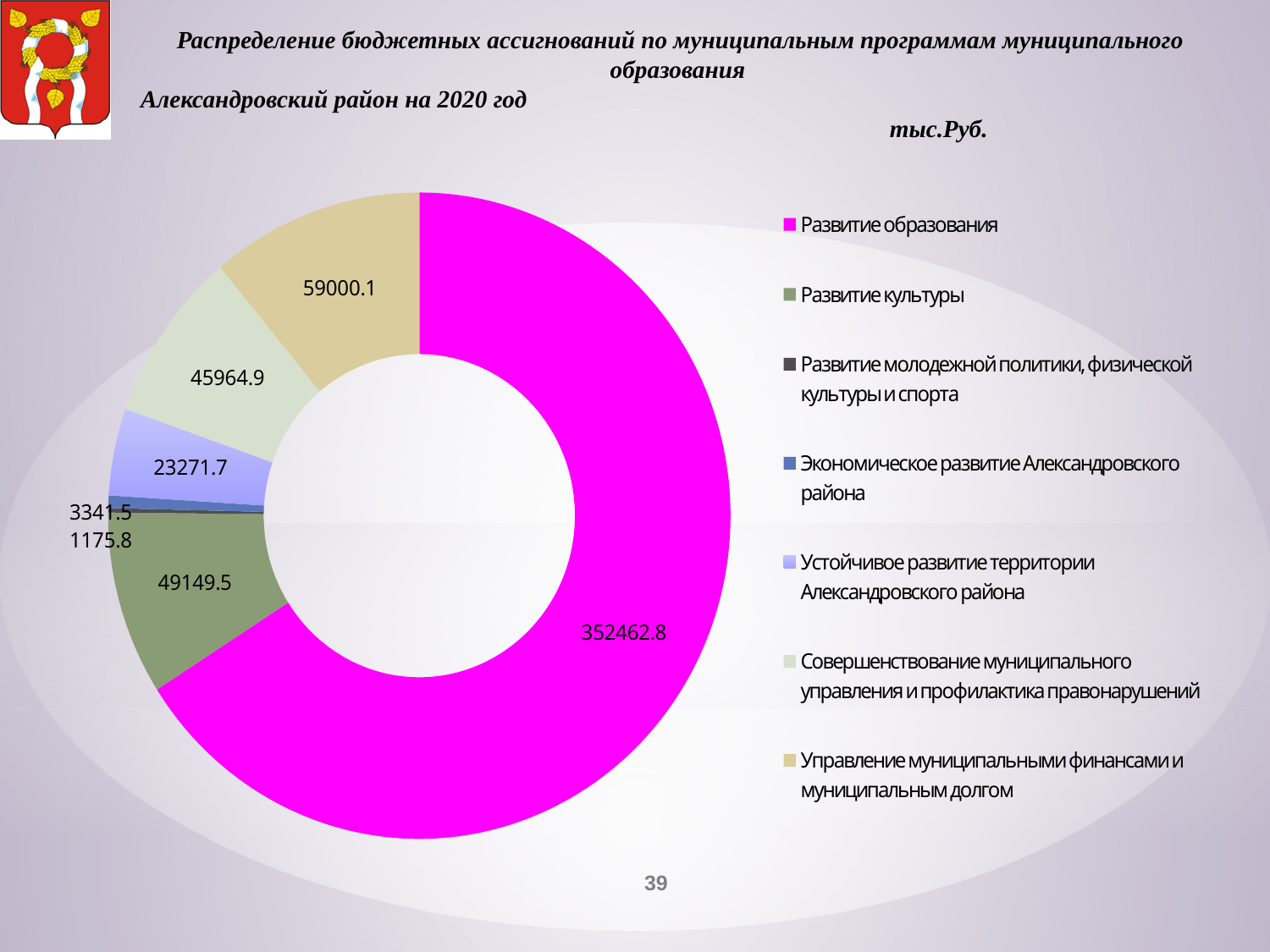
Which category has the largest value? Развитие образования How many categories does the legend list? 7 What is the value for Совершенствование муниципального управления и профилактика правонарушений? 45964.9 What is the value for Развитие образования? 352462.8 What is the value for Управление муниципальными финансами и муниципальным долгом? 59000.1 What is the value for Развитие культуры? 49149.5 What type of chart is shown on the slide? Pie (doughnut) chart Which is larger: Развитие культуры or Управление муниципальными финансами и муниципальным долгом? Управление муниципальными финансами и муниципальным долгом What is the smallest value shown on the chart? 1175.8 What is the value for Устойчивое развитие территории Александровского района? 23271.7 What is the difference between Управление муниципальными финансами и муниципальным долгом and Совершенствование муниципального управления и профилактика правонарушений? 13035.2 In what units are the values given, according to the slide? тыс.Руб.